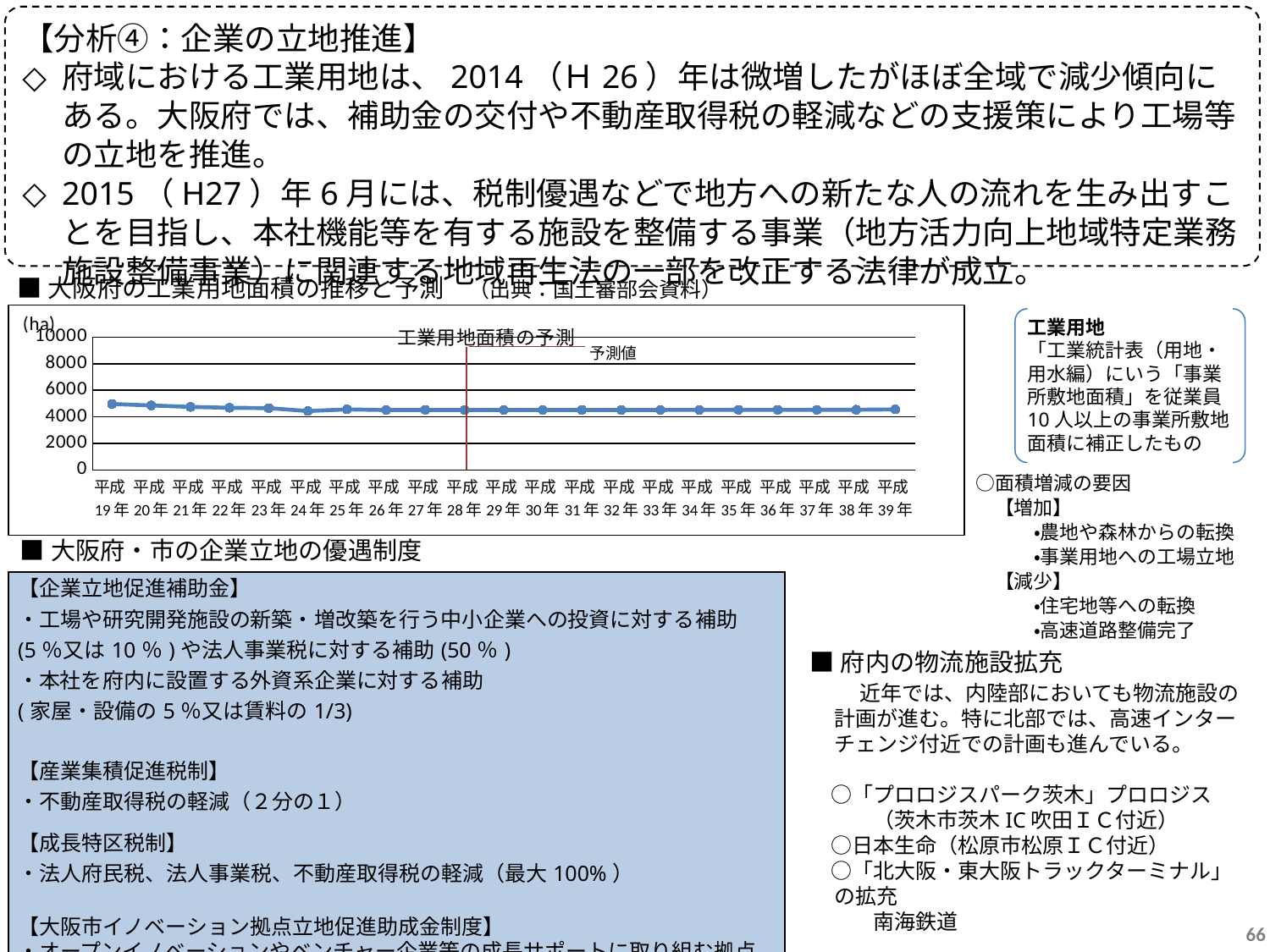
What is the highest tick value shown on the y axis of the chart? 10000 Which is larger, the value for 平成19年 or the value for 平成39年? 平成19年 What is the last year shown on the x axis of the chart? 平成39年 Is the value for 平成19年 greater or less than 6000? less How many data points are plotted on the line chart? 21 Do the values generally rise or fall from 平成19年 to 平成24年? fall What is the first year shown on the x axis of the chart? 平成19年 Is the value for 平成39年 greater or less than 6000? less Is the value for 平成30年 greater or less than 2000? greater Which year has the highest value on the chart? 平成19年 What kind of chart is shown on the slide? line chart